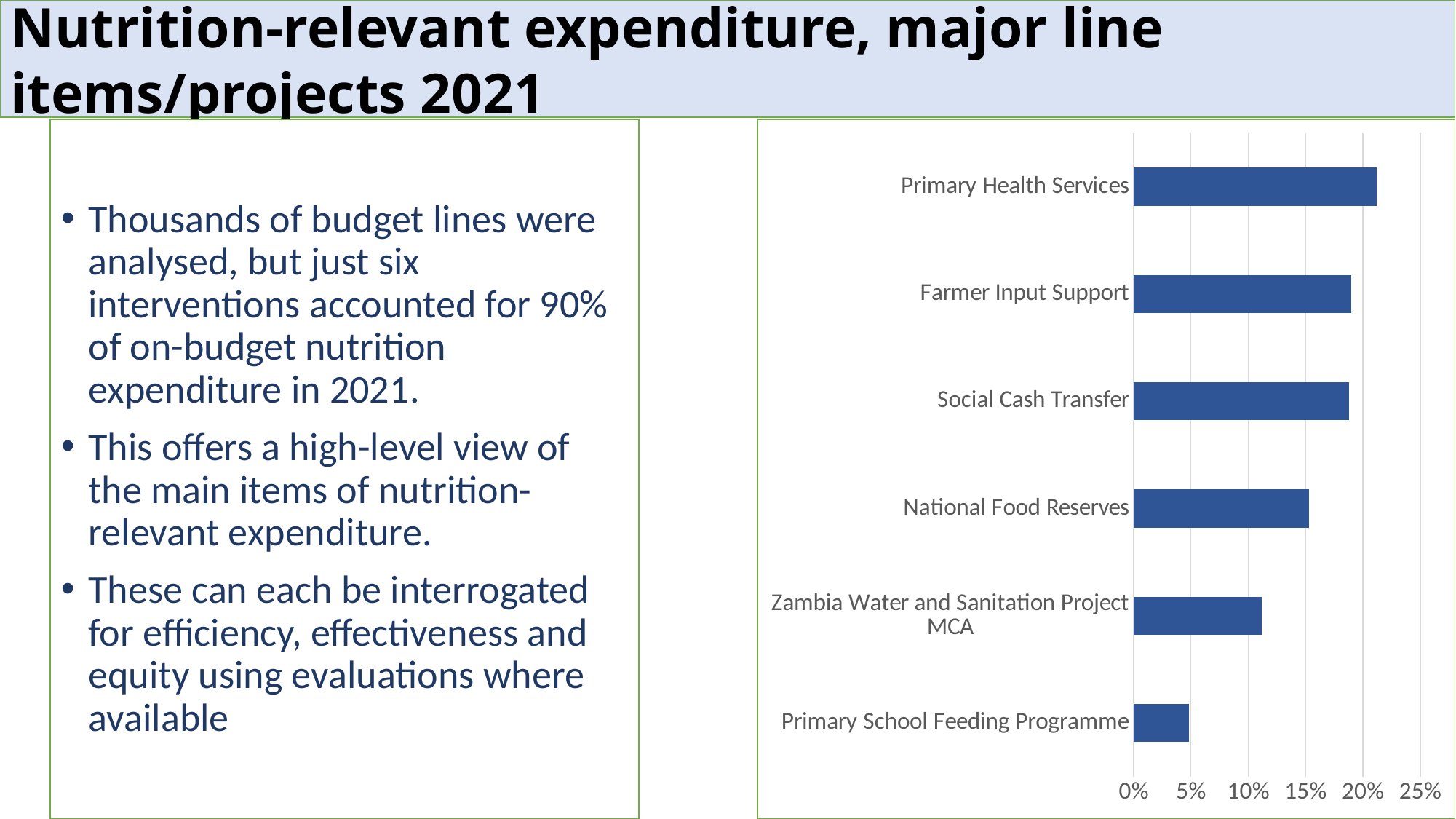
Is the value for Primary School Feeding Programme greater or less than 10%? less Which is larger, the value for Primary Health Services or the value for National Food Reserves? Primary Health Services How many categories are plotted in the chart? 6 What colour are the bars in the chart? blue Is the value for Social Cash Transfer greater or less than 15%? greater What kind of chart is shown on the slide? bar chart What is the highest value shown on the horizontal axis of the chart? 25% Which category has the highest value in the chart? Primary Health Services Which category has the lowest value in the chart? Primary School Feeding Programme Is the value for Primary Health Services greater or less than 20%? greater Which is larger, the value for National Food Reserves or the value for Zambia Water and Sanitation Project MCA? National Food Reserves